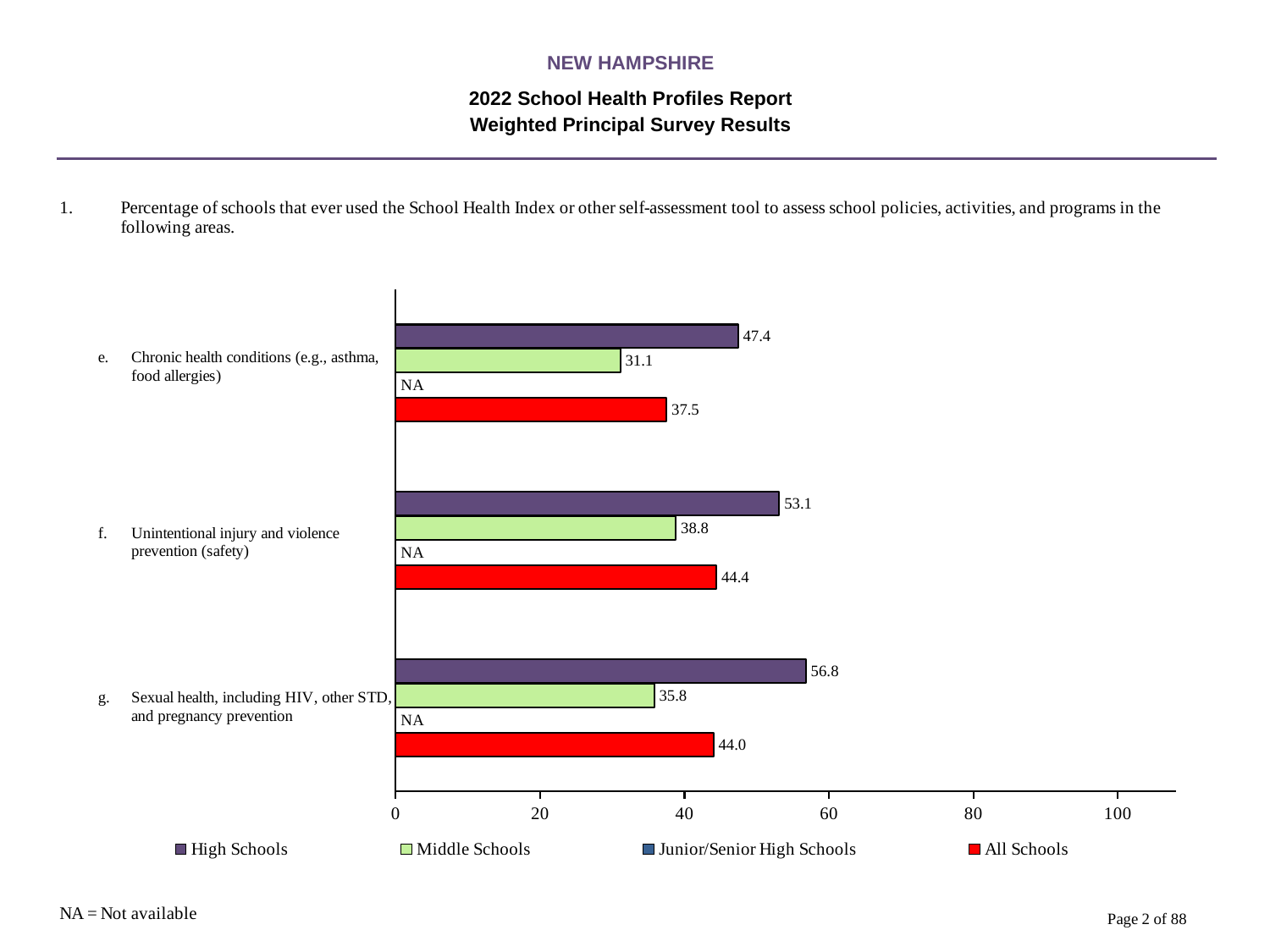
What is shown for Junior/Senior High Schools for Chronic health conditions? NA Which category has the lowest Middle Schools value? Chronic health conditions (e.g., asthma, food allergies) What is the difference between the High Schools and Middle Schools values for Unintentional injury and violence prevention (safety)? 14.3 What kind of chart is shown on the slide? bar chart What is the value for All Schools for Sexual health, including HIV, other STD, and pregnancy prevention? 44.0 Is the All Schools value for Chronic health conditions greater or less than 40? less How many series does the legend list? 4 What is the value for Middle Schools for Unintentional injury and violence prevention (safety)? 38.8 What is the value for High Schools for Chronic health conditions (e.g., asthma, food allergies)? 47.4 How many categories are shown on the chart? 3 Which category has the highest High Schools value? Sexual health, including HIV, other STD, and pregnancy prevention Which is larger for Sexual health: the High Schools value or the All Schools value? High Schools